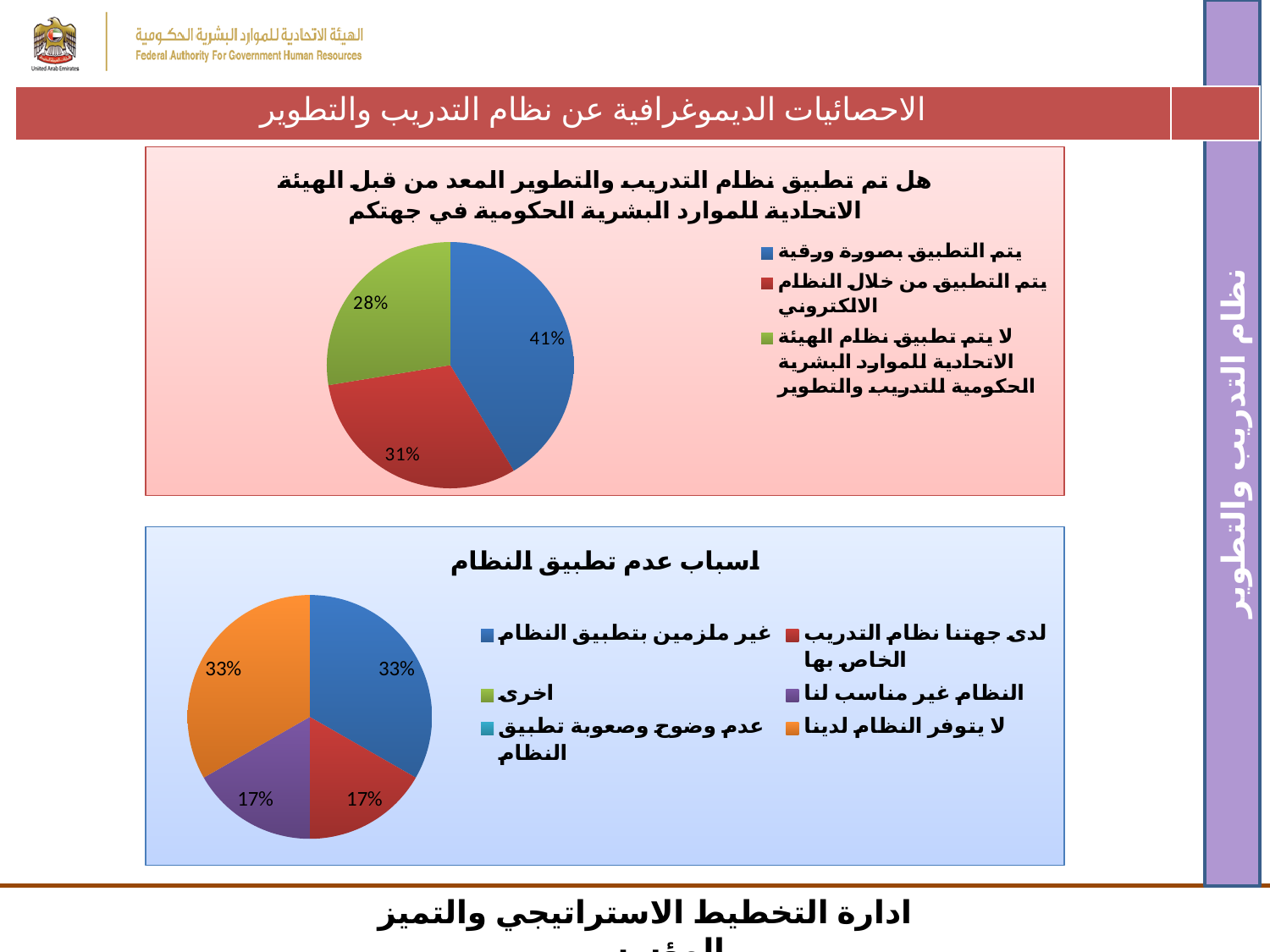
What type of chart is the bottom chart (اسباب عدم تطبيق النظام)? Pie chart In the top chart (هل تم تطبيق نظام التدريب والتطوير...), what percentage is shown for 'لا يتم تطبيق نظام الهيئة الاتحادية للموارد البشرية الحكومية للتدريب والتطوير'? 28% In the bottom chart (اسباب عدم تطبيق النظام), what percentage is shown for 'النظام غير مناسب لنا'? 17% In the top chart (هل تم تطبيق نظام التدريب والتطوير...), how many slices does the pie have? 3 In the top chart (هل تم تطبيق نظام التدريب والتطوير...), which category has the smallest share? لا يتم تطبيق نظام الهيئة الاتحادية للموارد البشرية الحكومية للتدريب والتطوير In the bottom chart (اسباب عدم تطبيق النظام), which is larger: 'لا يتوفر النظام لدينا' or 'لدى جهتنا نظام التدريب الخاص بها'? لا يتوفر النظام لدينا In the top chart (هل تم تطبيق نظام التدريب والتطوير...), what is the difference in percentage points between 'يتم التطبيق بصورة ورقية' and 'يتم التطبيق من خلال النظام الالكتروني'? 10 percentage points In the top chart (هل تم تطبيق نظام التدريب والتطوير...), what percentage is shown for 'يتم التطبيق من خلال النظام الالكتروني'? 31% In the top chart (هل تم تطبيق نظام التدريب والتطوير...), which category has the largest share? يتم التطبيق بصورة ورقية In the top chart (هل تم تطبيق نظام التدريب والتطوير...), what percentage is shown for 'يتم التطبيق بصورة ورقية'? 41% In the bottom chart (اسباب عدم تطبيق النظام), what percentage is shown for 'غير ملزمين بتطبيق النظام'? 33% How many entries does the legend of the bottom chart (اسباب عدم تطبيق النظام) list? 6